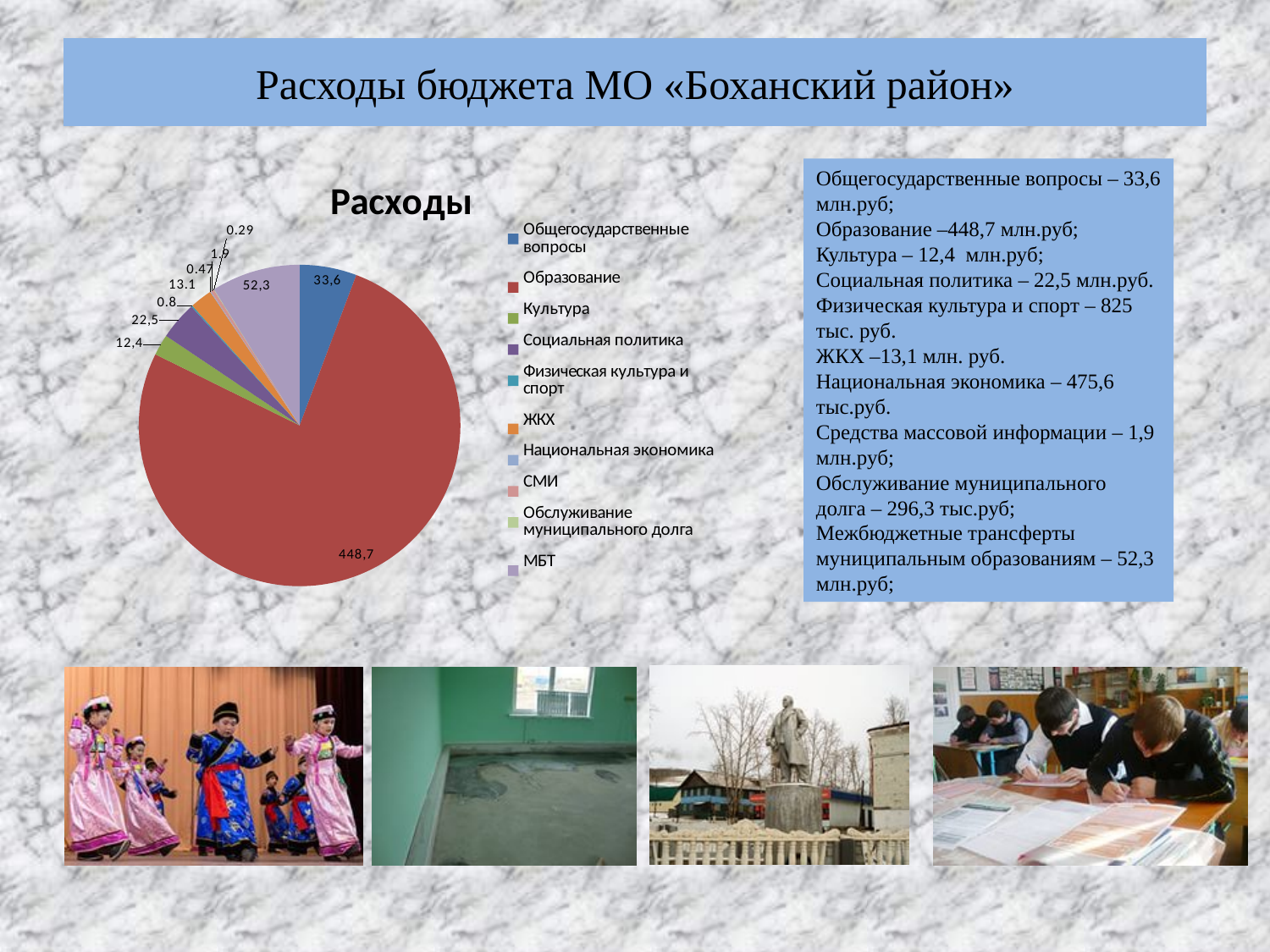
What type of chart is shown on the slide? pie chart What is the difference between the values for Образование and Общегосударственные вопросы? 415,1 What is the value shown for МБТ in the pie chart? 52,3 What is the value shown for Социальная политика in the pie chart? 22,5 What is the title of the chart? Расходы How many categories does the legend of the pie chart list? 10 Which category has the largest slice in the pie chart? Образование What is the value shown for Образование in the pie chart? 448,7 Which is larger in the pie chart, the value for МБТ or the value for Общегосударственные вопросы? МБТ What is the value shown for ЖКХ in the pie chart? 13.1 What is the value shown for Общегосударственные вопросы in the pie chart? 33,6 Which category has the smallest value in the pie chart? Обслуживание муниципального долга